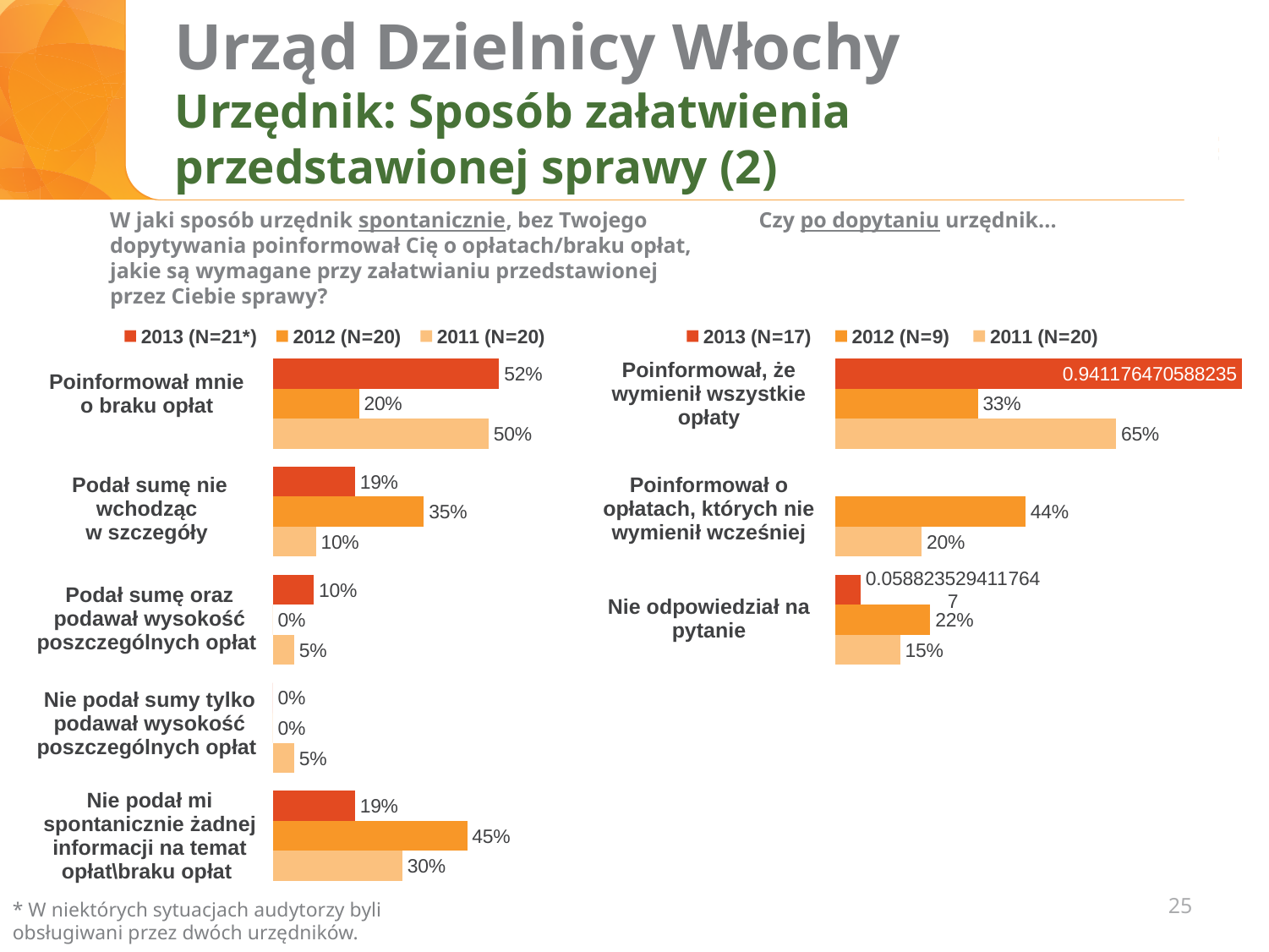
In the left chart, what is the 2012 value for "Nie podał mi spontanicznie żadnej informacji na temat opłat\braku opłat"? 45% In the right chart, what is the 2012 value for "Poinformował o opłatach, których nie wymienił wcześniej"? 44% How many categories does the left chart show? 5 What type of chart is the right chart? Bar chart In the left chart, what is the 2011 value for "Podał sumę nie wchodząc w szczegóły"? 10% In the left chart, which category has the highest 2013 value? Poinformował mnie o braku opłat How many series does the legend of the left chart list? 3 In the left chart, what is the difference between the 2013 and 2012 values for "Poinformował mnie o braku opłat"? 32 percentage points In the left chart, for "Podał sumę nie wchodząc w szczegóły", which year has the larger value, 2012 or 2013? 2012 In the left chart, what is the 2013 value for "Poinformował mnie o braku opłat"? 52% In the right chart, what is the difference between the 2012 and 2011 values for "Nie odpowiedział na pytanie"? 7 percentage points In the right chart, what is the 2011 value for "Poinformował, że wymienił wszystkie opłaty"? 65%